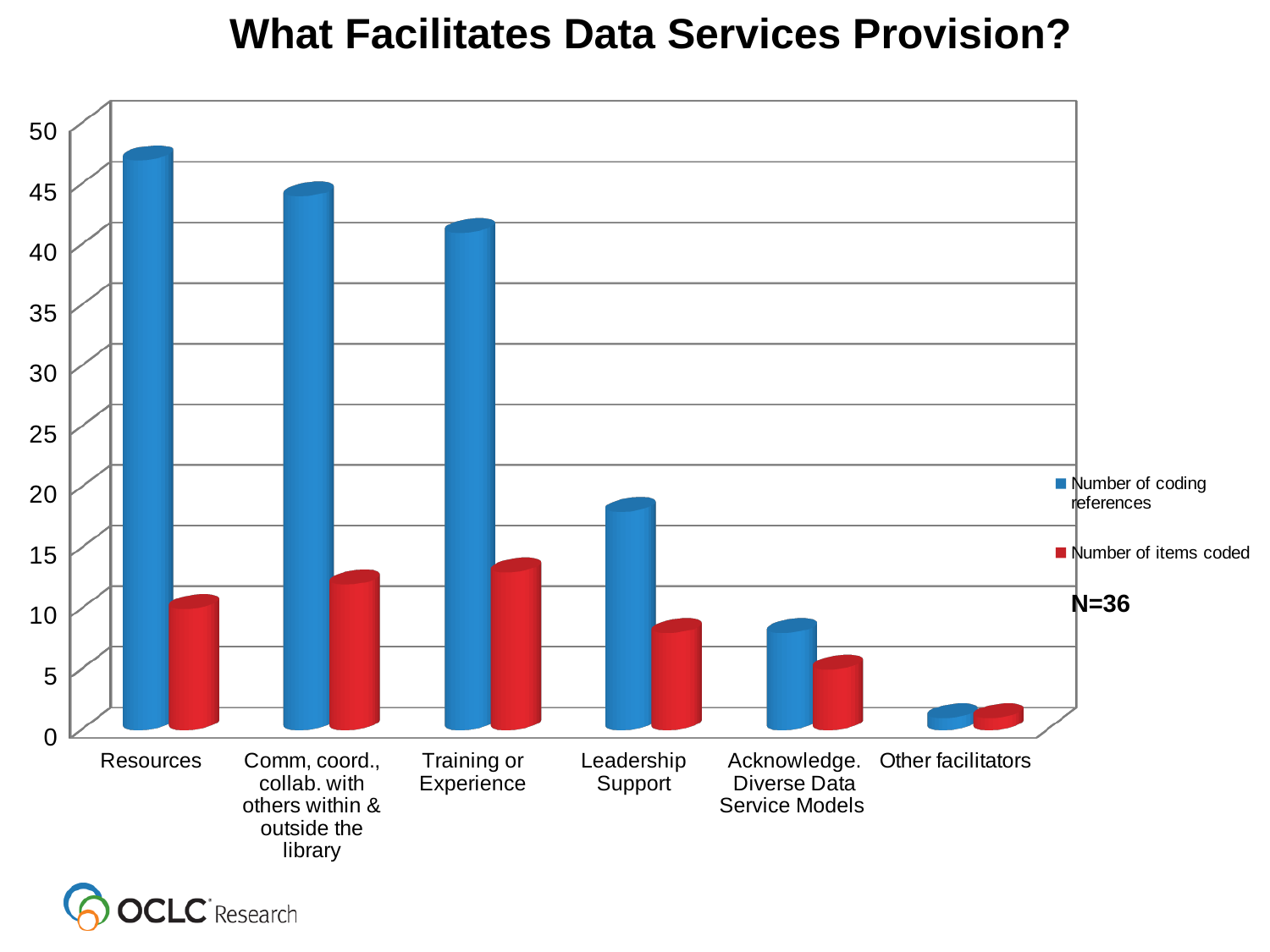
What sample size (N) is stated on the slide? N=36 How many categories are shown along the x axis? 6 Is the number of coding references for Resources greater or less than 40? greater Which category has the highest number of coding references? Resources What kind of chart is shown on the slide? bar chart Do the number of coding references values rise or fall from left to right across the categories? fall For Leadership Support, which is larger: the number of coding references or the number of items coded? Number of coding references Is the number of coding references for Leadership Support greater or less than 25? less How many series does the legend list? 2 Which category has the lowest number of coding references? Other facilitators Is the number of items coded for Acknowledge. Diverse Data Service Models greater or less than 10? less Which has more coding references, Resources or Training or Experience? Resources